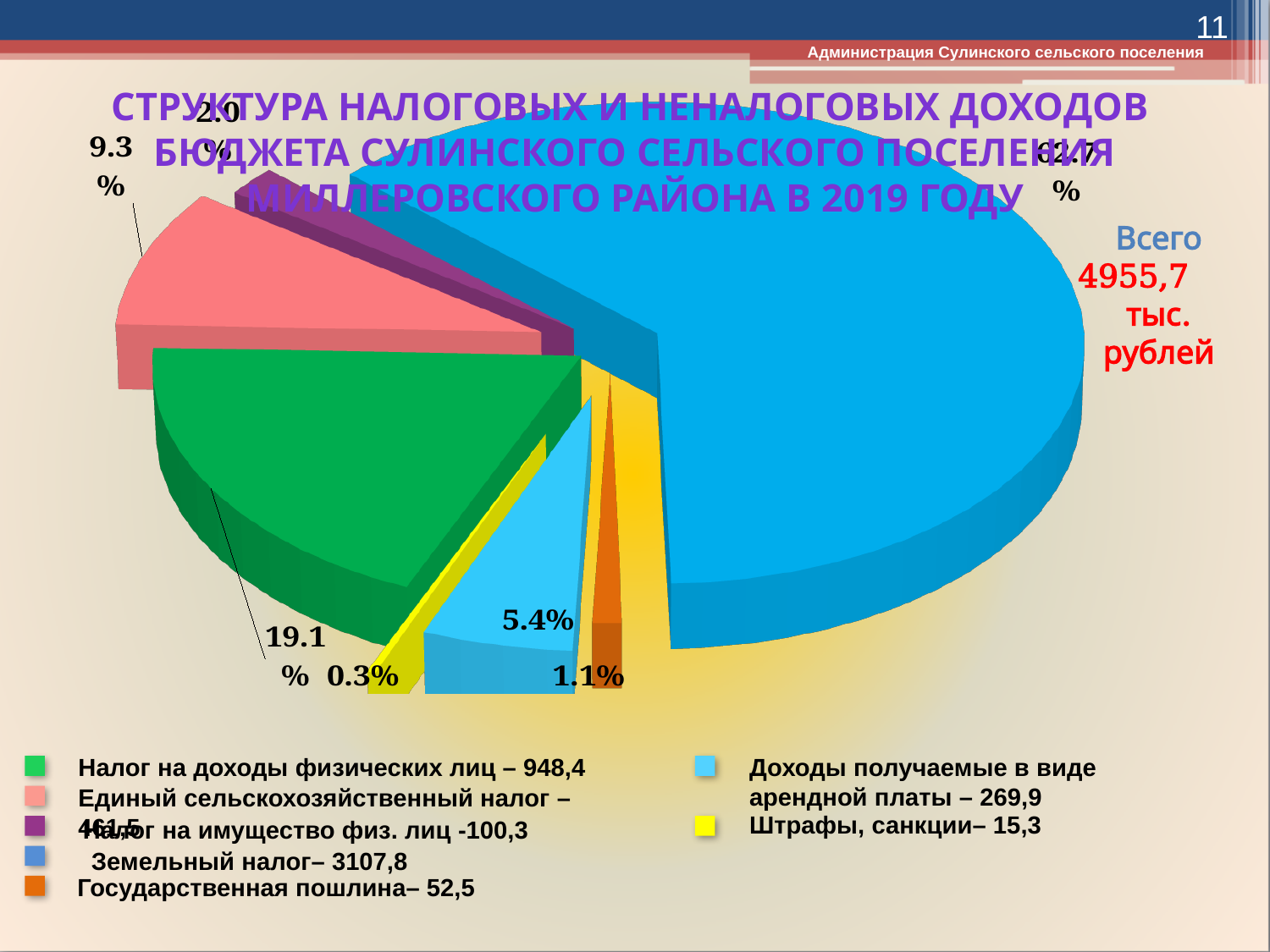
What is the difference in percentage points between the slice for Налог на доходы физических лиц and the slice for Единый сельскохозяйственный налог? 9.8 What share of the pie does Государственная пошлина have? 1.1% What kind of chart is shown on the slide? pie chart How many slices does the pie chart have? 7 What total amount (Всего) is shown next to the pie chart? 4955,7 тыс. рублей Which category has the largest slice of the pie chart? Земельный налог What share of the pie does Налог на имущество физ. лиц have? 2.0% What share of the pie does Доходы получаемые в виде арендной платы have? 5.4% Which category has the smallest slice of the pie chart? Штрафы, санкции Which is larger: the slice for Единый сельскохозяйственный налог or the slice for Доходы получаемые в виде арендной платы? Единый сельскохозяйственный налог